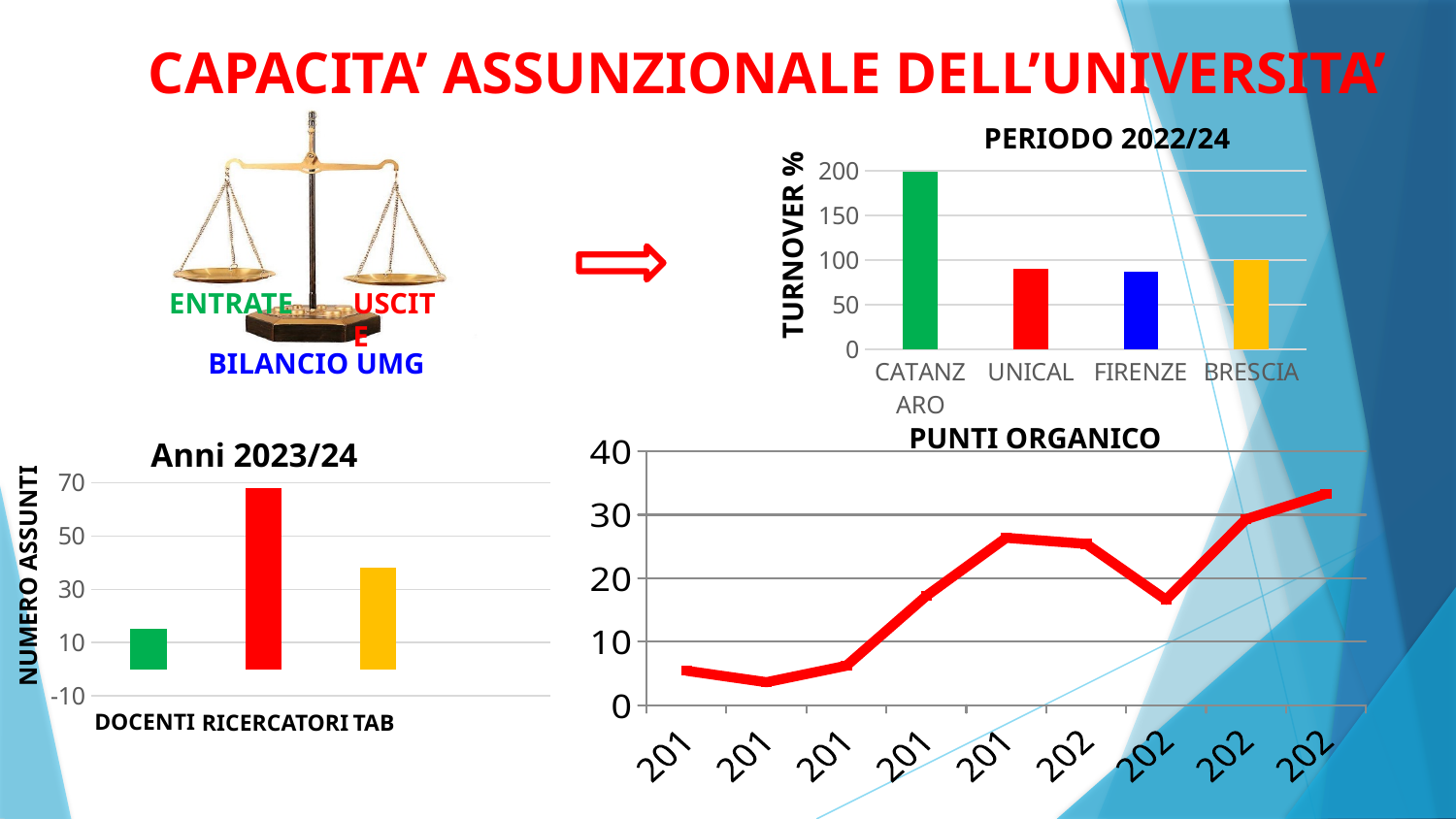
In the 'Anni 2023/24' chart, which category has the lowest number of hires? DOCENTI How many categories are shown in the 'PERIODO 2022/24' chart? 4 In the 'PUNTI ORGANICO' chart, do the values overall rise or fall from left to right? rise What kind of chart is the 'PUNTI ORGANICO' chart? line chart What kind of chart is the 'PERIODO 2022/24' chart? bar chart In the 'PERIODO 2022/24' chart, is the value for BRESCIA greater or less than 50? greater In the 'PERIODO 2022/24' chart, which category has the highest turnover %? CATANZARO In the 'PERIODO 2022/24' chart, is the value for UNICAL greater or less than 100? less In the 'Anni 2023/24' chart, which category has the highest number of hires? RICERCATORI In the 'Anni 2023/24' chart, is the value for RICERCATORI greater or less than 50? greater In the 'PERIODO 2022/24' chart, which is larger, CATANZARO or BRESCIA? CATANZARO What is the y-axis title of the 'PERIODO 2022/24' chart? TURNOVER %